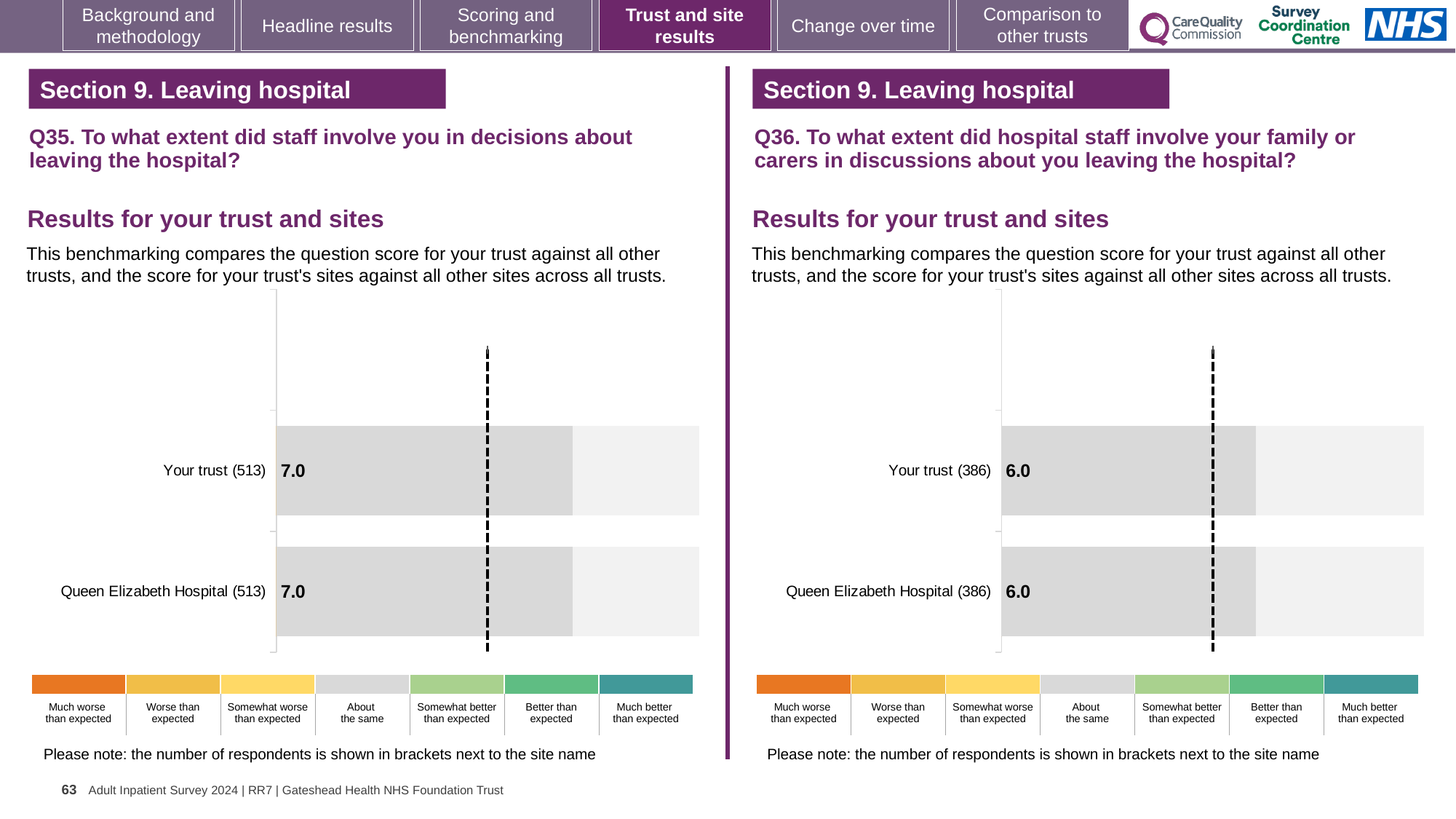
In the Q35 chart on the left, what is the score for Your trust? 7.0 In the Q36 chart on the right, what is the difference between the score for Your trust and the score for Queen Elizabeth Hospital? 0.0 In the Q36 chart on the right, how many respondents are shown in brackets next to Queen Elizabeth Hospital? 386 In the Q36 chart on the right, what is the score for Queen Elizabeth Hospital? 6.0 In the Q35 chart on the left, what is the difference between the score for Your trust and the score for Queen Elizabeth Hospital? 0.0 In the Q35 chart on the left, how many respondents are shown in brackets next to Your trust? 513 In the Q35 chart on the left, what is the score for Queen Elizabeth Hospital? 7.0 In the Q36 chart on the right, what is the score for Your trust? 6.0 How many bars are plotted in the Q36 chart on the right? 2 What kind of chart is used in the Q35 chart on the left? Bar chart How many bars are plotted in the Q35 chart on the left? 2 Is the score for Your trust in the Q35 chart on the left larger or smaller than the score for Your trust in the Q36 chart on the right? Larger